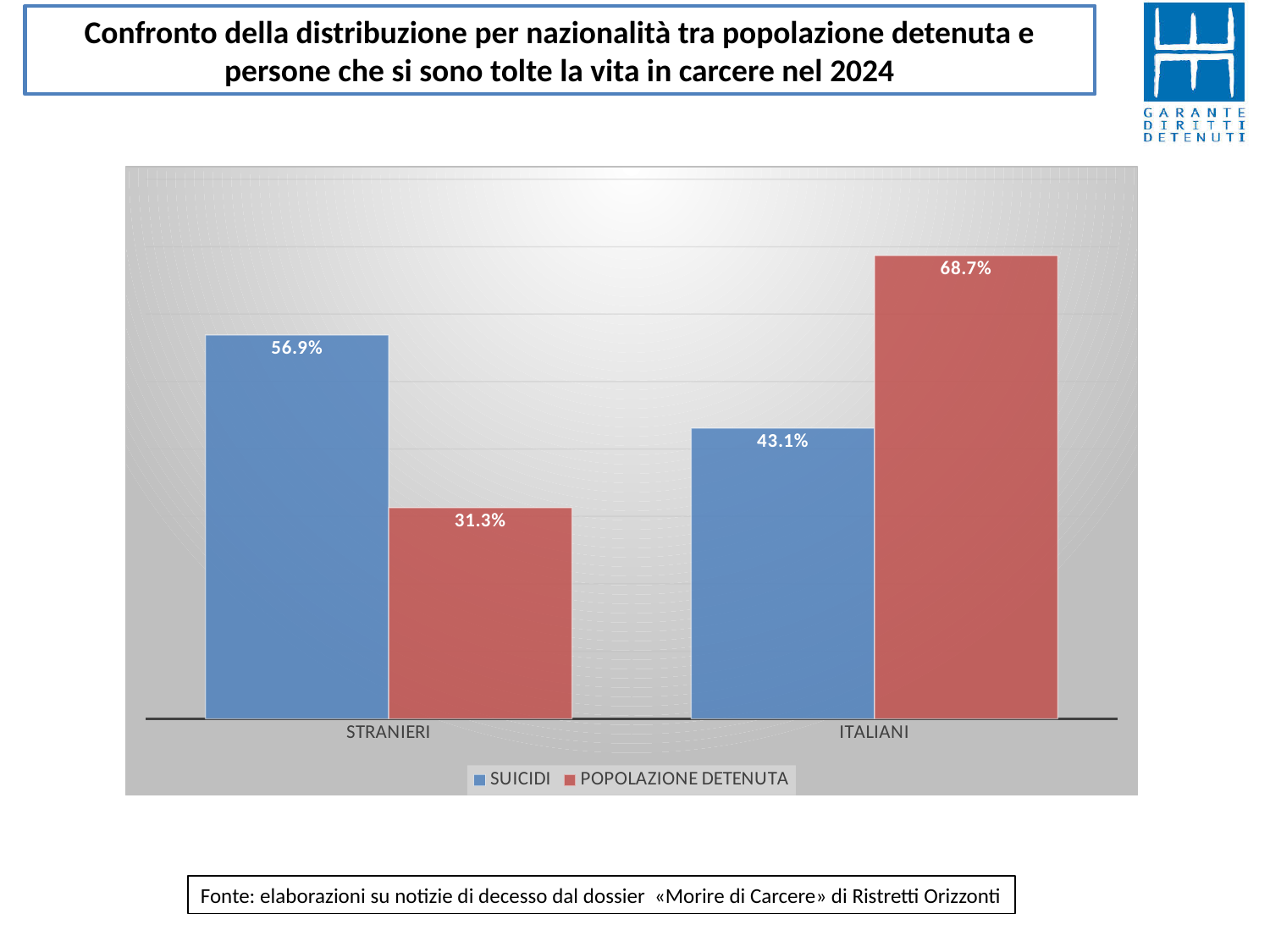
What is the SUICIDI value for STRANIERI? 56.9% How many categories are shown on the x axis? 2 What is the difference between the SUICIDI values for STRANIERI and ITALIANI? 13.8% Which category has the highest POPOLAZIONE DETENUTA value? ITALIANI What is the SUICIDI value for ITALIANI? 43.1% What is the POPOLAZIONE DETENUTA value for STRANIERI? 31.3% What kind of chart is shown on the slide? Bar chart What is the POPOLAZIONE DETENUTA value for ITALIANI? 68.7% How many series does the legend list? 2 For STRANIERI, which is larger: SUICIDI or POPOLAZIONE DETENUTA? SUICIDI Which category has the lowest SUICIDI value? ITALIANI What is the difference between the POPOLAZIONE DETENUTA values for ITALIANI and STRANIERI? 37.4%